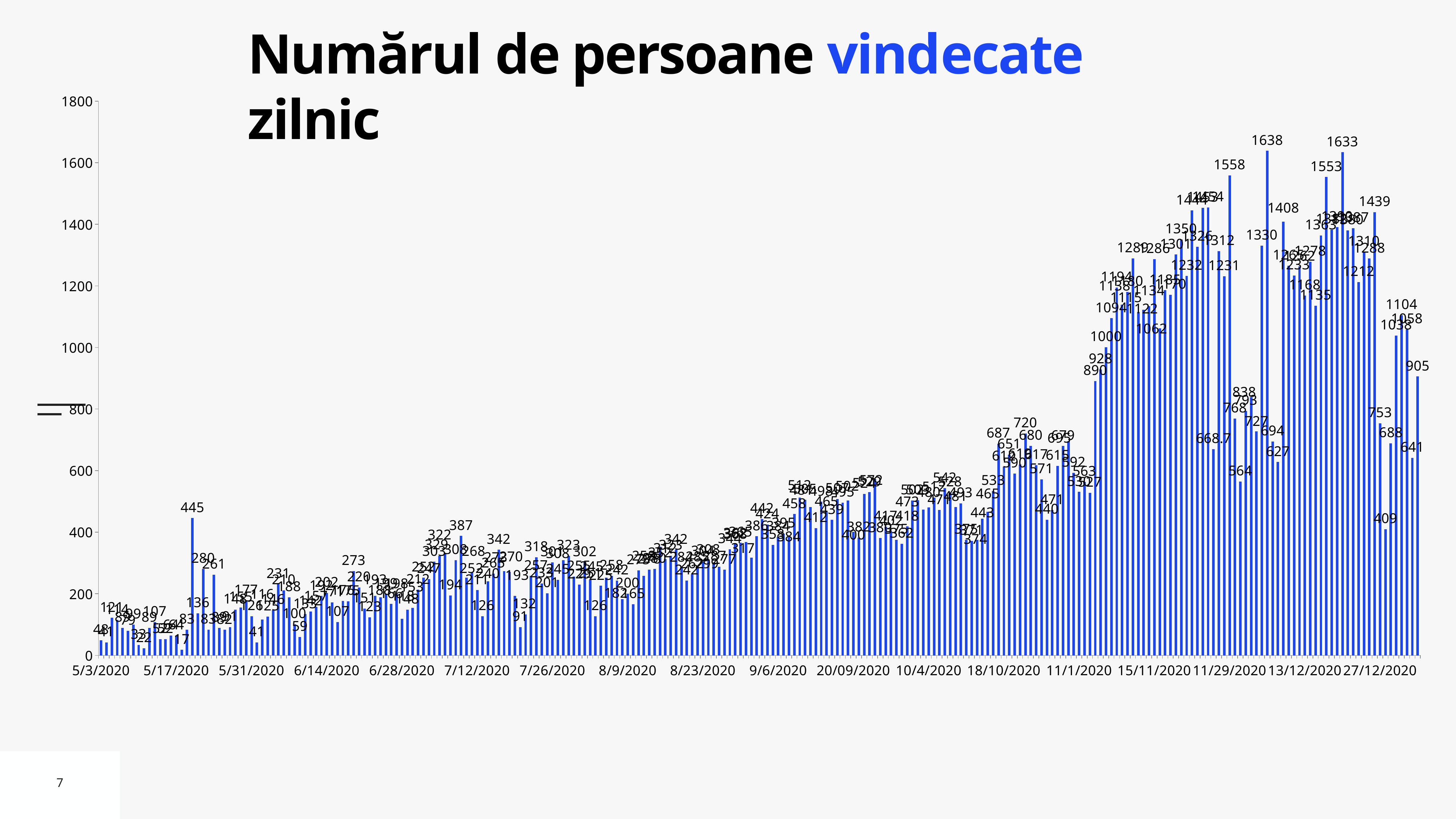
What is the highest value printed on the chart? 1638 What is the difference between the two highest labelled values, 1638 and 1633? 5 What kind of chart is shown on the slide? bar chart What is the value of the tall spike bar in May 2020, shortly after 5/17/2020? 445 Is the highest bar on the chart greater or less than 1600? greater What is the title of the chart? Numărul de persoane vindecate zilnic Which is larger, the highest bar in May 2020 (445) or the highest bar in December 2020 (1633)? 1633 Overall, do the daily values rise or fall from May 2020 to December 2020? rise Is the value for 5/31/2020 greater or less than 400? less Is the value for 5/3/2020 greater or less than 200? less What is the value of the last (rightmost) bar on the chart? 905 What is the maximum value shown on the vertical axis? 1800